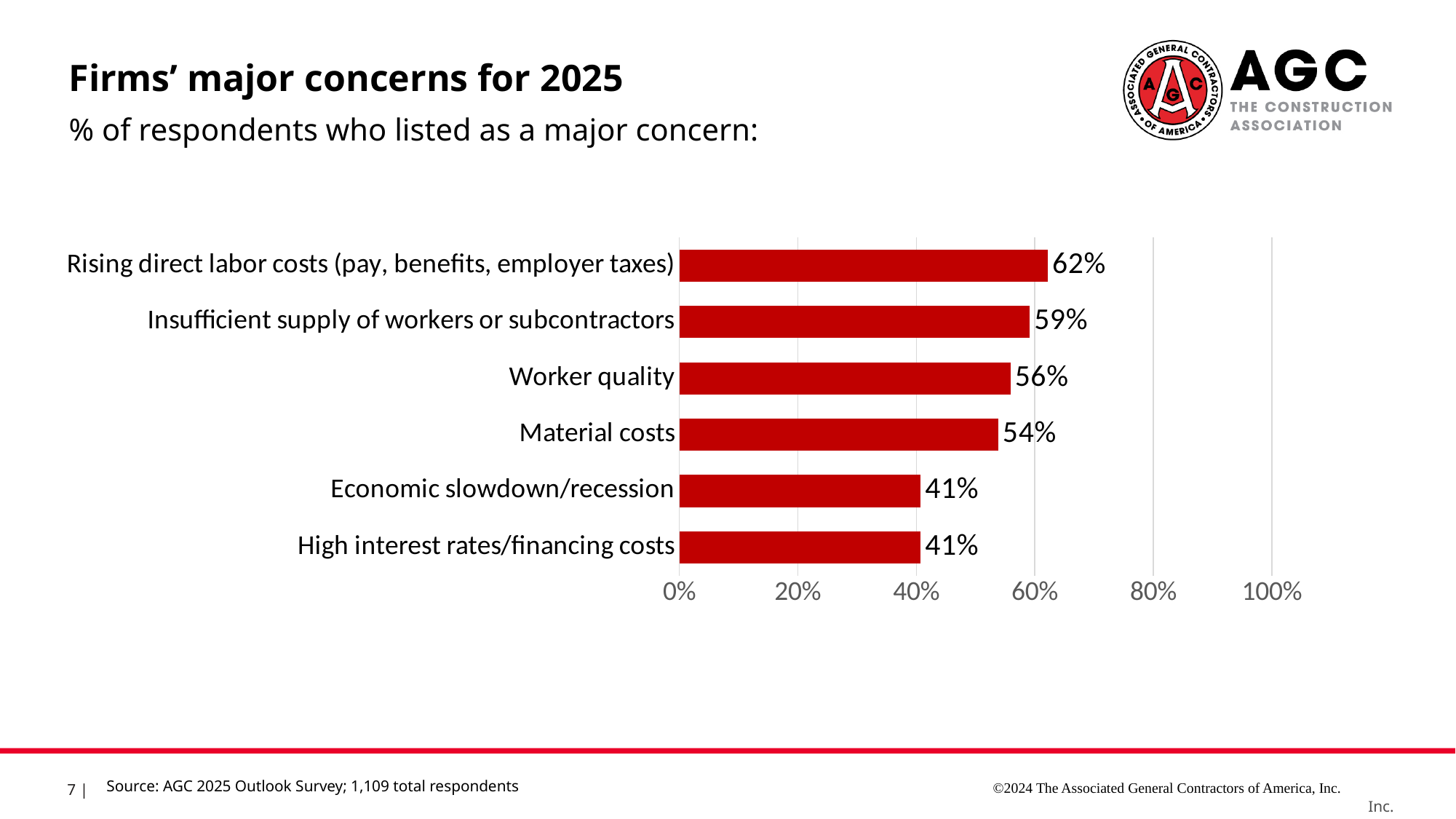
How many concerns are shown in the chart? 6 What is the difference in percentage points between rising direct labor costs and high interest rates/financing costs? 21 percentage points What is the difference in percentage points between insufficient supply of workers or subcontractors and material costs? 5 percentage points What percentage of respondents listed worker quality as a major concern? 56% What percentage of respondents listed economic slowdown/recession as a major concern? 41% What kind of chart is shown on the slide? Bar chart What is the title of the slide? Firms' major concerns for 2025 What percentage of respondents listed material costs as a major concern? 54% Which was listed as a major concern by more respondents: worker quality or material costs? Worker quality Is the value for insufficient supply of workers or subcontractors greater or less than 40%? greater What percentage of respondents listed rising direct labor costs (pay, benefits, employer taxes) as a major concern? 62% Which concern was listed by the highest percentage of respondents? Rising direct labor costs (pay, benefits, employer taxes)